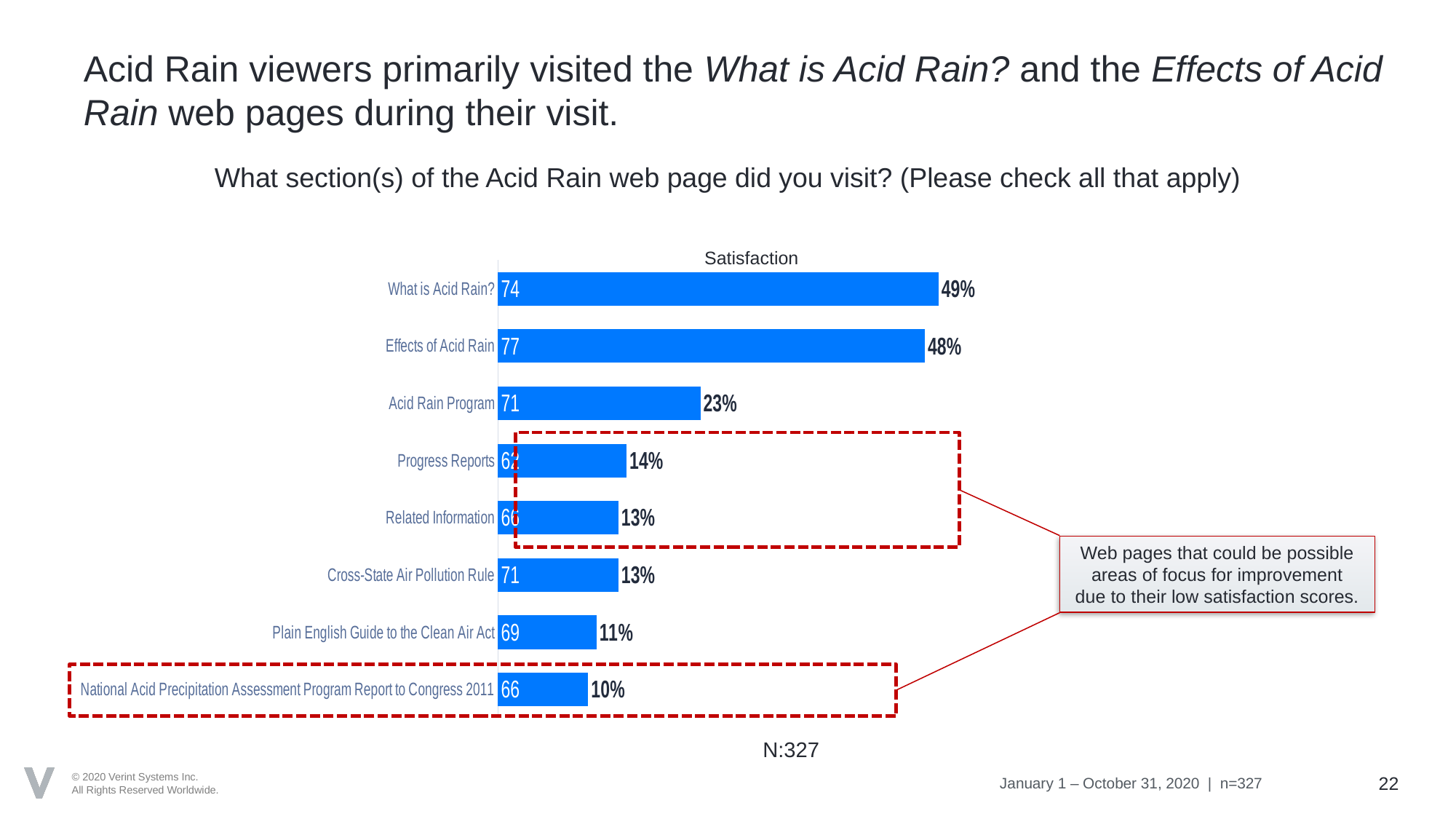
What percentage of respondents visited the What is Acid Rain? section? 49% What kind of chart is shown on the slide? Bar chart What is the difference in percentage points between Effects of Acid Rain and Acid Rain Program? 25 Which has a higher percentage of visitors, Progress Reports or Plain English Guide to the Clean Air Act? Progress Reports What percentage of respondents visited the Acid Rain Program section? 23% Which section has the lowest percentage of visitors? National Acid Precipitation Assessment Program Report to Congress 2011 What is the satisfaction score shown for the National Acid Precipitation Assessment Program Report to Congress 2011? 66 What is the N value shown below the chart? N:327 How many sections are listed in the chart? 8 What is the satisfaction score shown for Effects of Acid Rain? 77 Which section has the highest percentage of visitors? What is Acid Rain? What is the difference in satisfaction score between Effects of Acid Rain and Plain English Guide to the Clean Air Act? 8